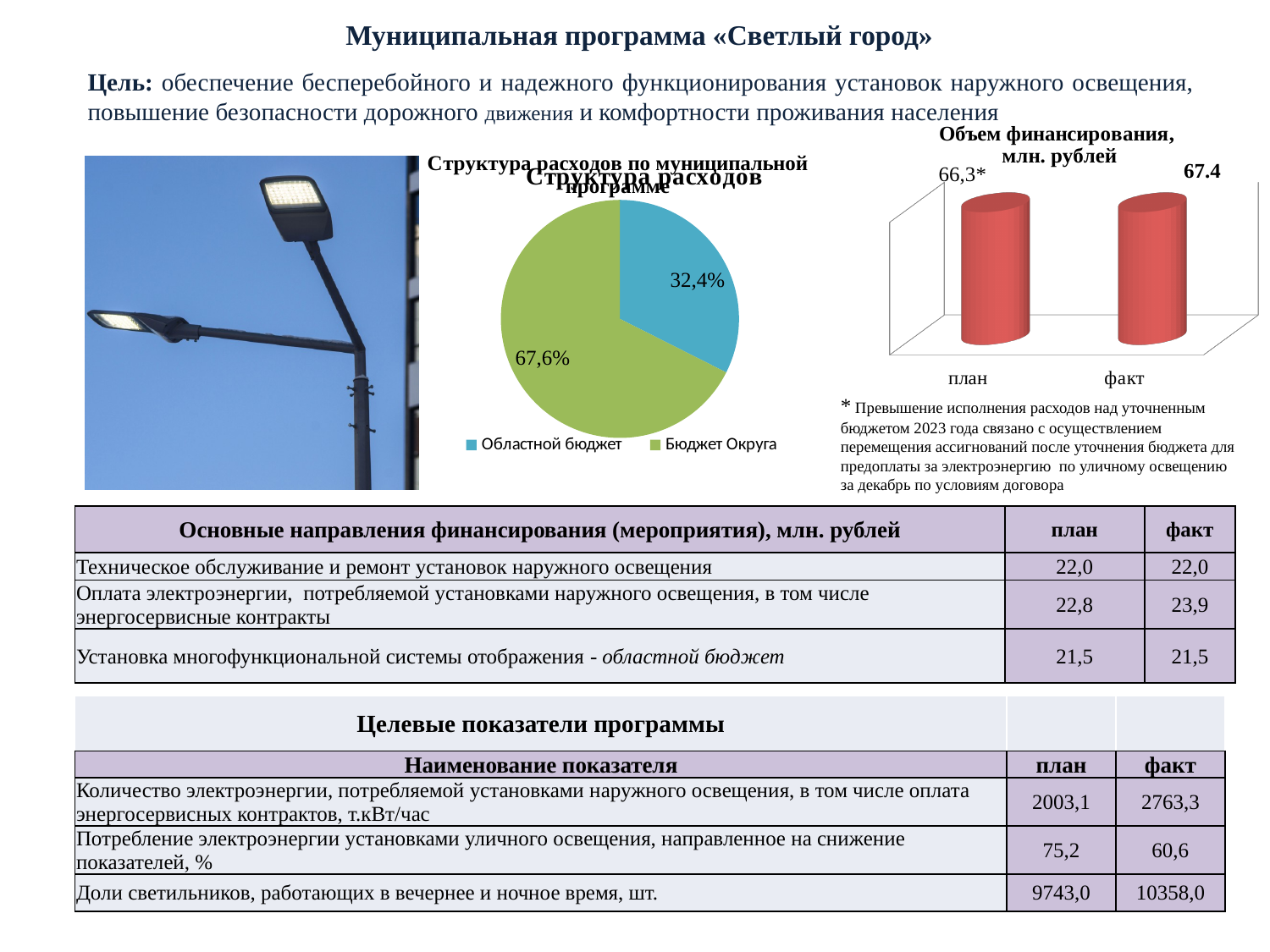
What kind of chart is the chart titled «Объем финансирования, млн. рублей»? bar chart In the pie chart «Структура расходов», what is the difference between the «Бюджет Округа» share and the «Областной бюджет» share? 35,2% In the pie chart «Структура расходов», which slice is the largest? Бюджет Округа In the chart «Объем финансирования, млн. рублей», what is the value for «факт»? 67.4 In the chart «Объем финансирования, млн. рублей», how many bars are there? 2 In the pie chart «Структура расходов», which slice is the smallest? Областной бюджет In the chart «Объем финансирования, млн. рублей», what is the value for «план»? 66,3 In the pie chart «Структура расходов», what colour is the «Областной бюджет» slice? blue In the pie chart «Структура расходов», what share does «Бюджет Округа» have? 67,6% What kind of chart is the chart titled «Структура расходов»? pie chart In the pie chart «Структура расходов», what share does «Областной бюджет» have? 32,4% In the pie chart «Структура расходов», how many slices are there? 2